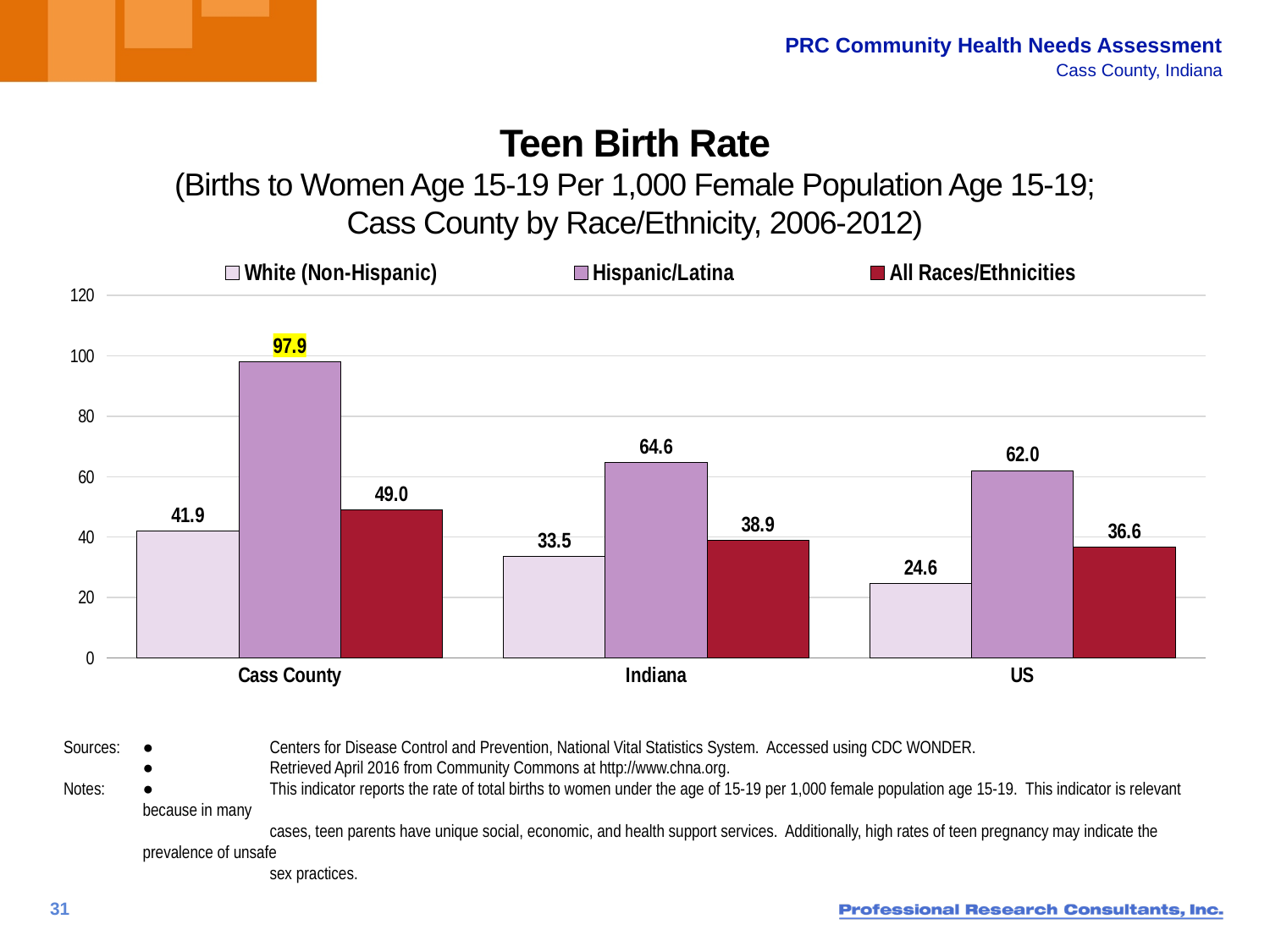
Which data label is highlighted in yellow on the chart? 97.9 What is the teen birth rate for Hispanic/Latina women in Cass County? 97.9 Which geography has the highest Hispanic/Latina teen birth rate? Cass County How many series does the legend list? 3 How many geographic categories are shown on the x axis? 3 What kind of chart is shown on the slide? Bar chart What is the teen birth rate for All Races/Ethnicities in Indiana? 38.9 What is the teen birth rate for White (Non-Hispanic) women in the US? 24.6 Which is larger, the All Races/Ethnicities rate for Cass County or for the US? Cass County What is the difference between the Hispanic/Latina and White (Non-Hispanic) teen birth rates in Cass County? 56.0 Is the Hispanic/Latina teen birth rate in Indiana greater or less than 60? greater Which geography has the lowest White (Non-Hispanic) teen birth rate? US